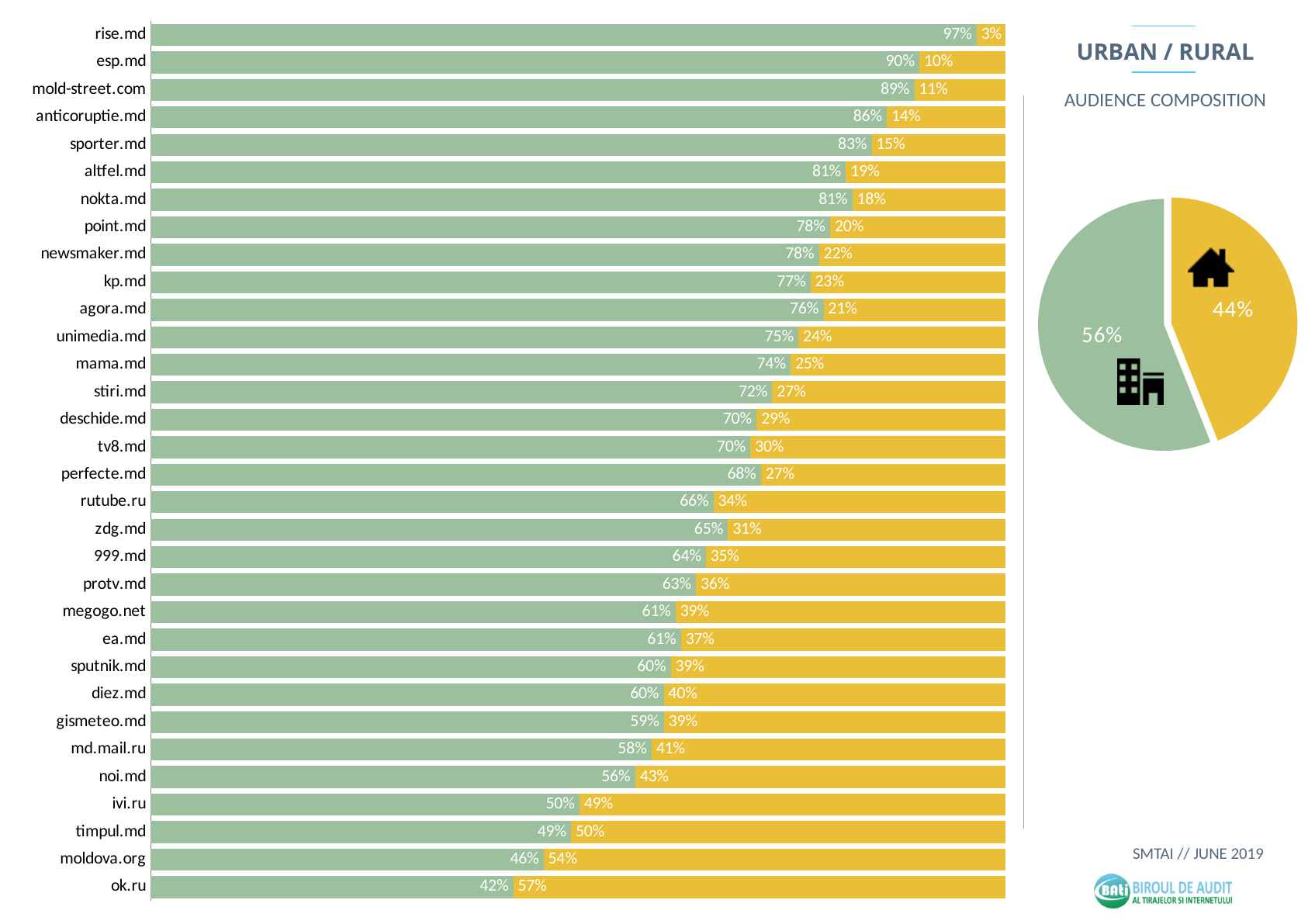
In the pie chart, what share is shown for the green slice? 56% In the bar chart, what is the value of the yellow segment for deschide.md? 29% In the bar chart, which site has the highest green-segment value? rise.md In the bar chart, what is the value of the yellow segment for ok.ru? 57% How many sites are listed in the bar chart? 32 In the bar chart, which site has a larger yellow-segment value, protv.md or noi.md? noi.md In the bar chart, what is the value of the green segment for rise.md? 97% What is the title shown above the pie chart? URBAN / RURAL What type of chart is used on the left side of the slide? bar chart In the pie chart, what share is shown for the yellow slice? 44% In the bar chart, which site has the lowest green-segment value? ok.ru In the bar chart, what is the difference between the green-segment values of esp.md and sporter.md? 7%